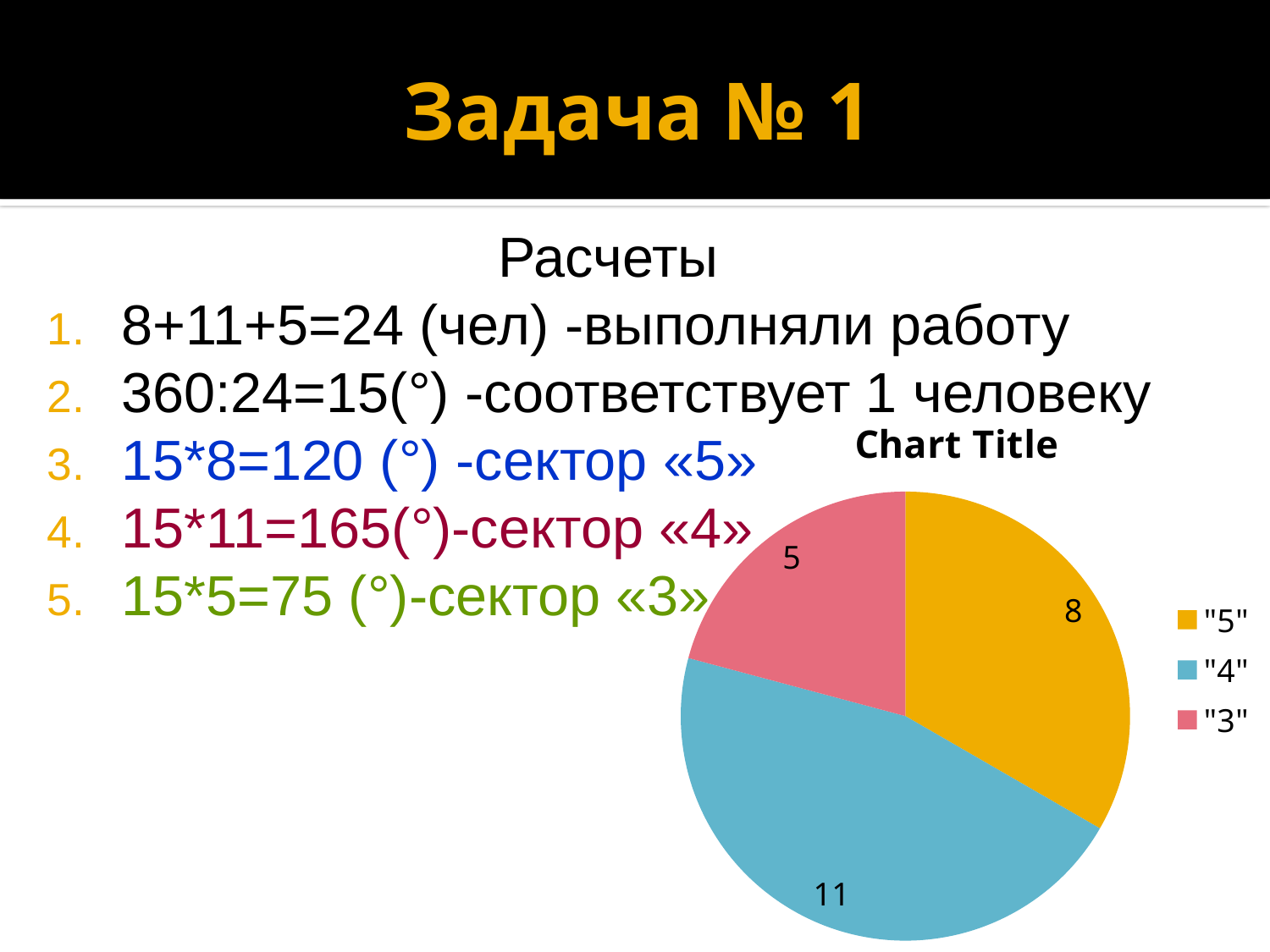
Which category has the smallest slice in the pie chart? "3" What is the value of the "5" slice in the pie chart? 8 How many slices does the pie chart have? 3 What colour is the "4" slice in the pie chart? blue What is the difference between the "4" slice and the "5" slice? 3 Which category has the largest slice in the pie chart? "4" What is the title of the chart? Chart Title How many entries does the legend list? 3 Which is larger, the "5" slice or the "3" slice? "5" What kind of chart is shown on the slide? pie chart What is the value of the "3" slice in the pie chart? 5 What is the value of the "4" slice in the pie chart? 11